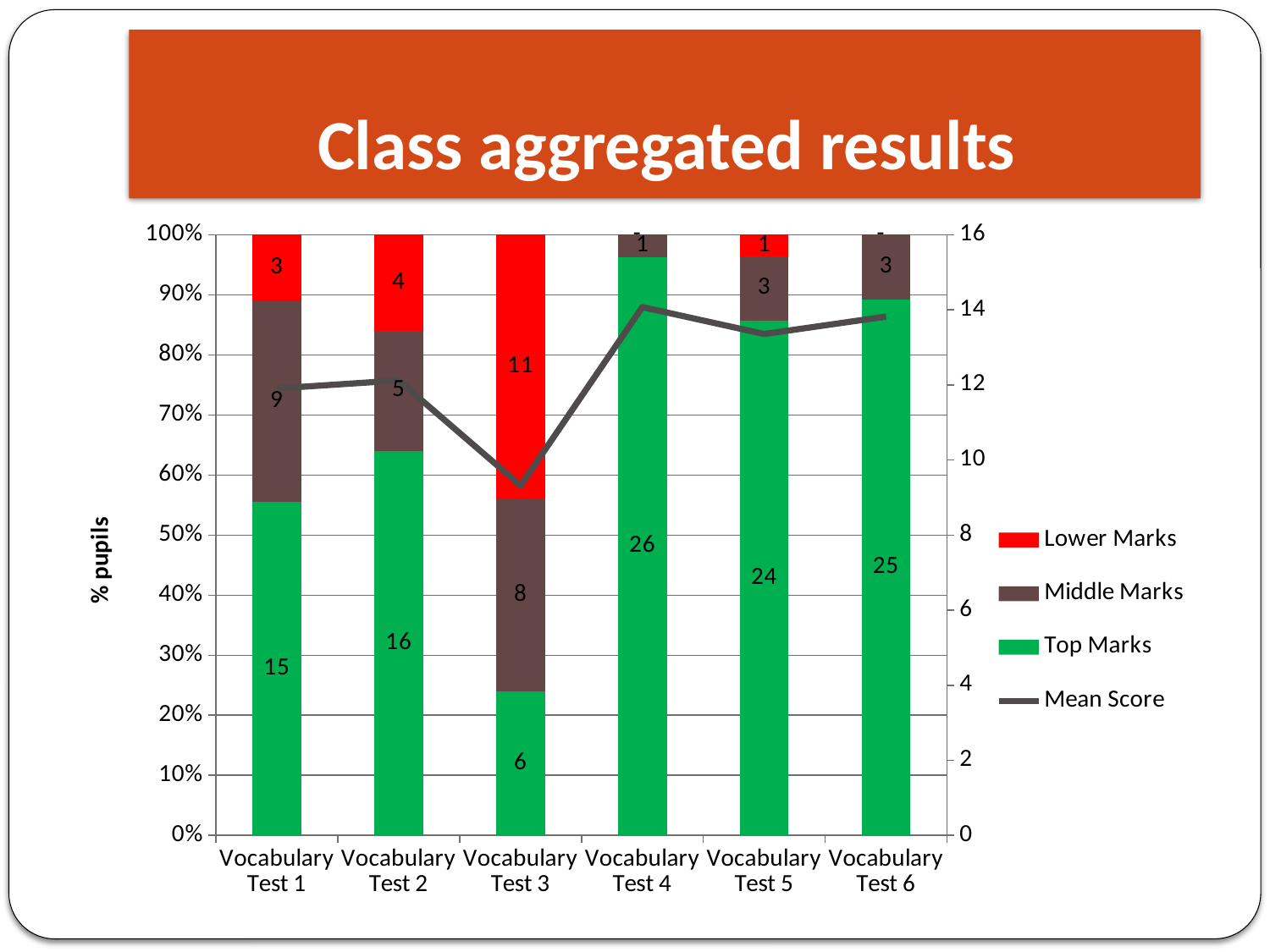
Which has the larger Middle Marks value, Vocabulary Test 1 or Vocabulary Test 3? Vocabulary Test 1 What is the Top Marks value for Vocabulary Test 4? 26 What is the Middle Marks value for Vocabulary Test 1? 9 What is the Lower Marks value for Vocabulary Test 3? 11 What is the total number of pupils across Lower, Middle and Top Marks for Vocabulary Test 1? 27 How many tests are shown on the x axis? 6 Which test has the lowest Top Marks value? Vocabulary Test 3 Which test has the highest Top Marks value? Vocabulary Test 4 Which test has the highest Lower Marks value? Vocabulary Test 3 How many series does the legend list? 4 What is the difference between the Top Marks values for Vocabulary Test 4 and Vocabulary Test 3? 20 Is the Mean Score for Vocabulary Test 3 greater or less than 10? less